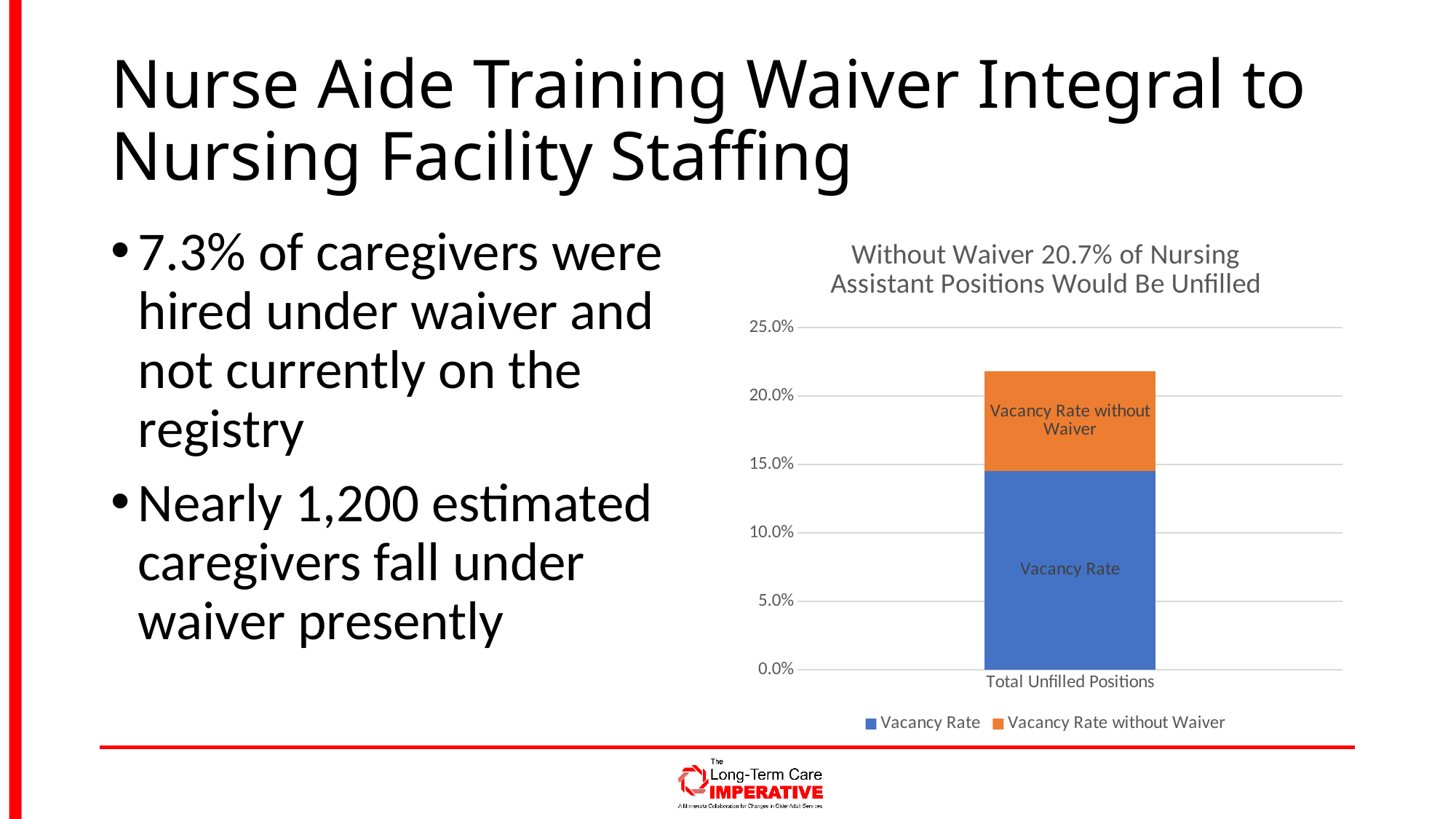
What kind of chart is shown on the slide? stacked bar chart Is the Vacancy Rate segment for Total Unfilled Positions greater or less than 15.0%? less How many categories are shown on the x axis of the chart? 1 Which series is shown in orange in the chart? Vacancy Rate without Waiver How many series does the chart legend list? 2 Which series is at the bottom of the stacked bar for Total Unfilled Positions? Vacancy Rate What is the title of the chart? Without Waiver 20.7% of Nursing Assistant Positions Would Be Unfilled Which series is larger for Total Unfilled Positions, Vacancy Rate or Vacancy Rate without Waiver? Vacancy Rate Is the Vacancy Rate segment for Total Unfilled Positions greater or less than 10.0%? greater What is the category label on the x axis of the chart? Total Unfilled Positions Is the top of the stacked bar for Total Unfilled Positions greater or less than 20.0%? greater